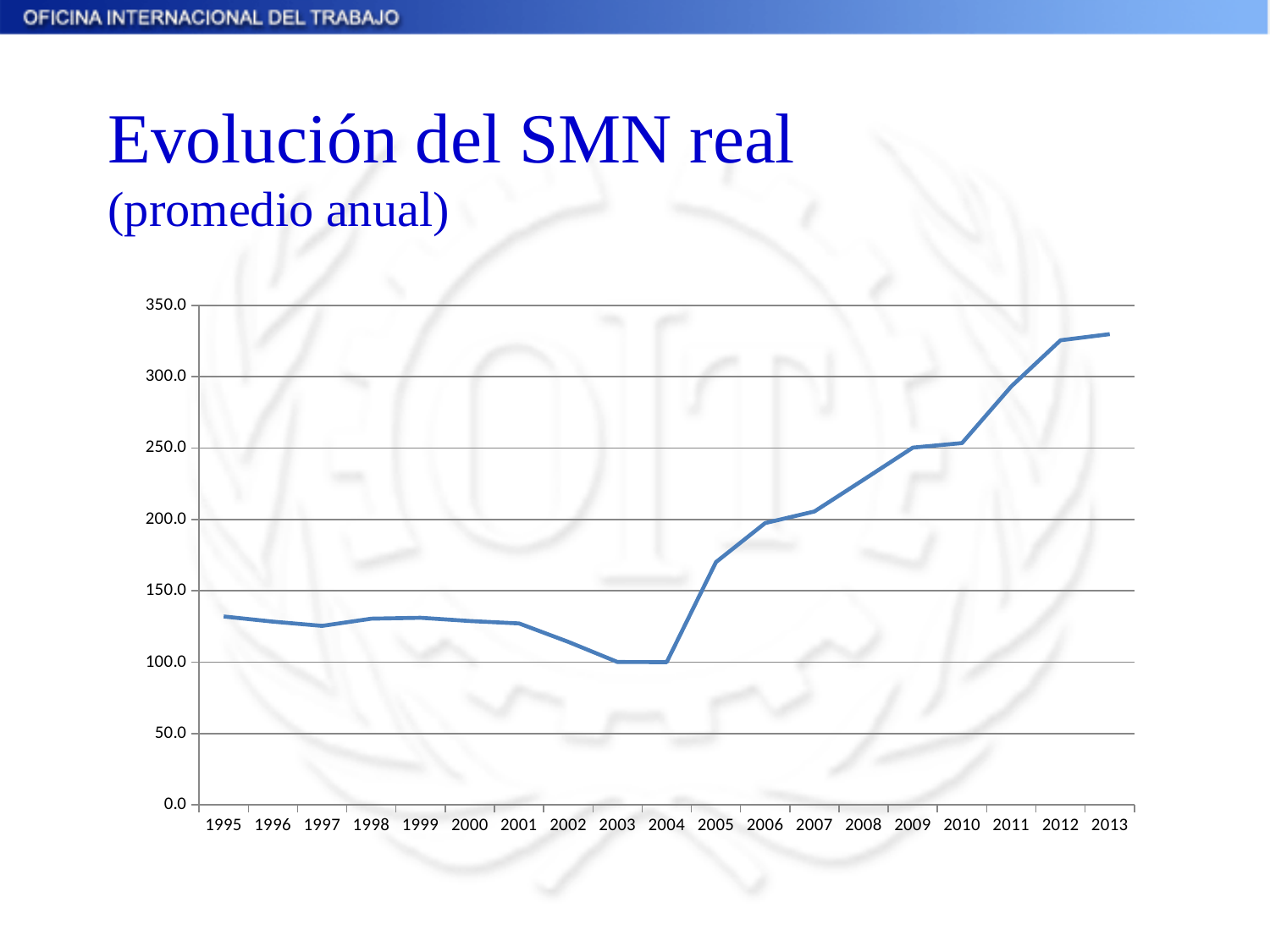
Is the value for 2008 greater or less than 250.0? less What kind of chart is shown on the slide? line chart Is the value for 2005 greater or less than 150.0? greater Is the value for 1995 greater or less than 150.0? less What is the title of the slide containing the chart? Evolución del SMN real (promedio anual) Which is larger, the value for 1999 or the value for 2003? 1999 How many years are plotted along the x axis of the chart? 19 Which year has the highest value in the chart? 2013 Do the values rise or fall from 2004 to 2013? rise Which is larger, the value for 1995 or the value for 2013? 2013